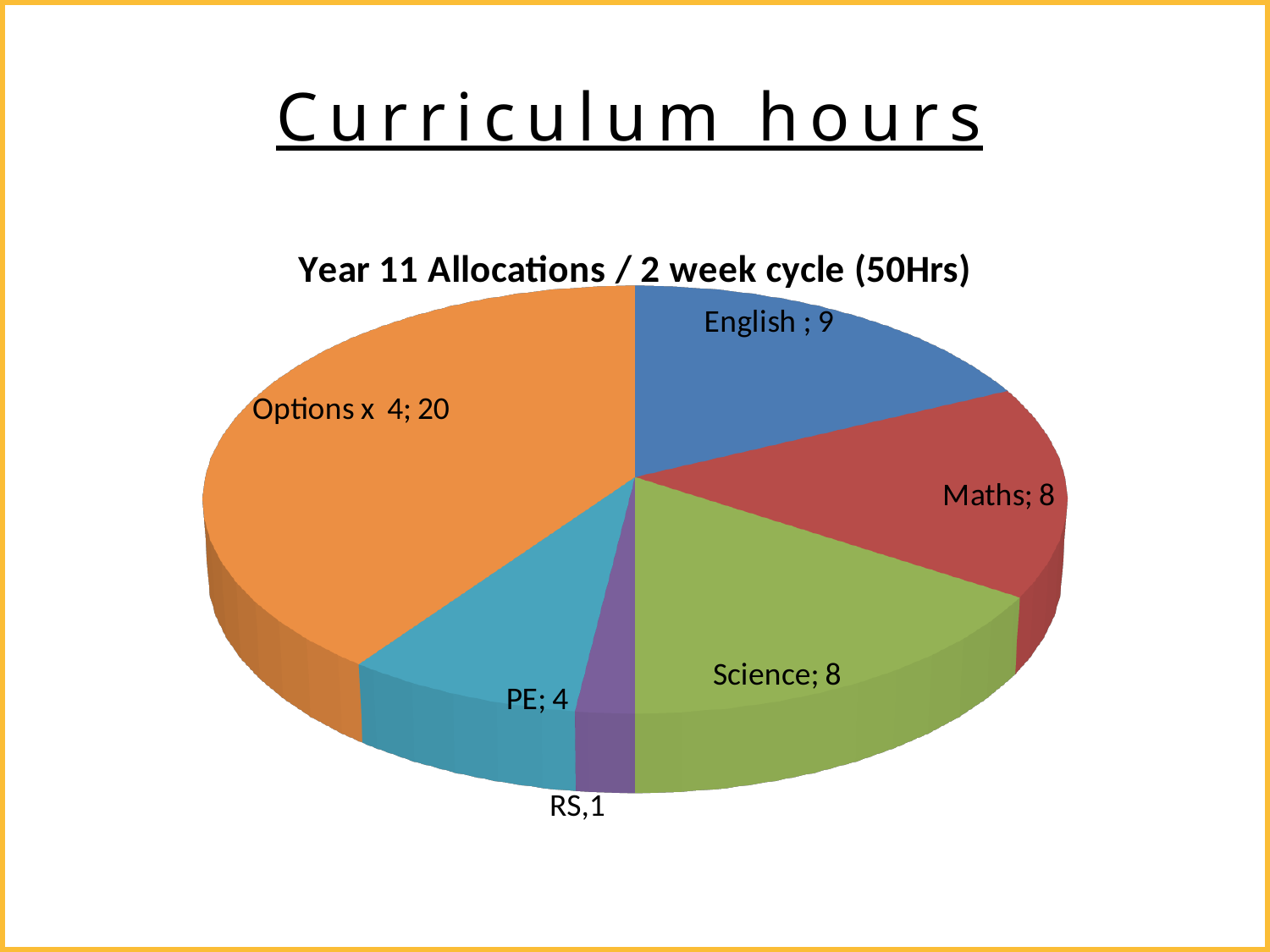
Which has more hours, English or Science? English How many hours are allocated to RS? 1 What is the chart's title? Year 11 Allocations / 2 week cycle (50Hrs) How many categories are shown in the pie chart? 6 How many hours are allocated to Options x 4? 20 Which category has the smallest slice of the pie? RS How many hours are allocated to PE? 4 What is the difference in hours between Options x 4 and English? 11 What share of the total 50 hours is allocated to Options x 4? 40% What kind of chart is shown on the slide? Pie chart How many hours are allocated to English? 9 Which category has the largest slice of the pie? Options x 4